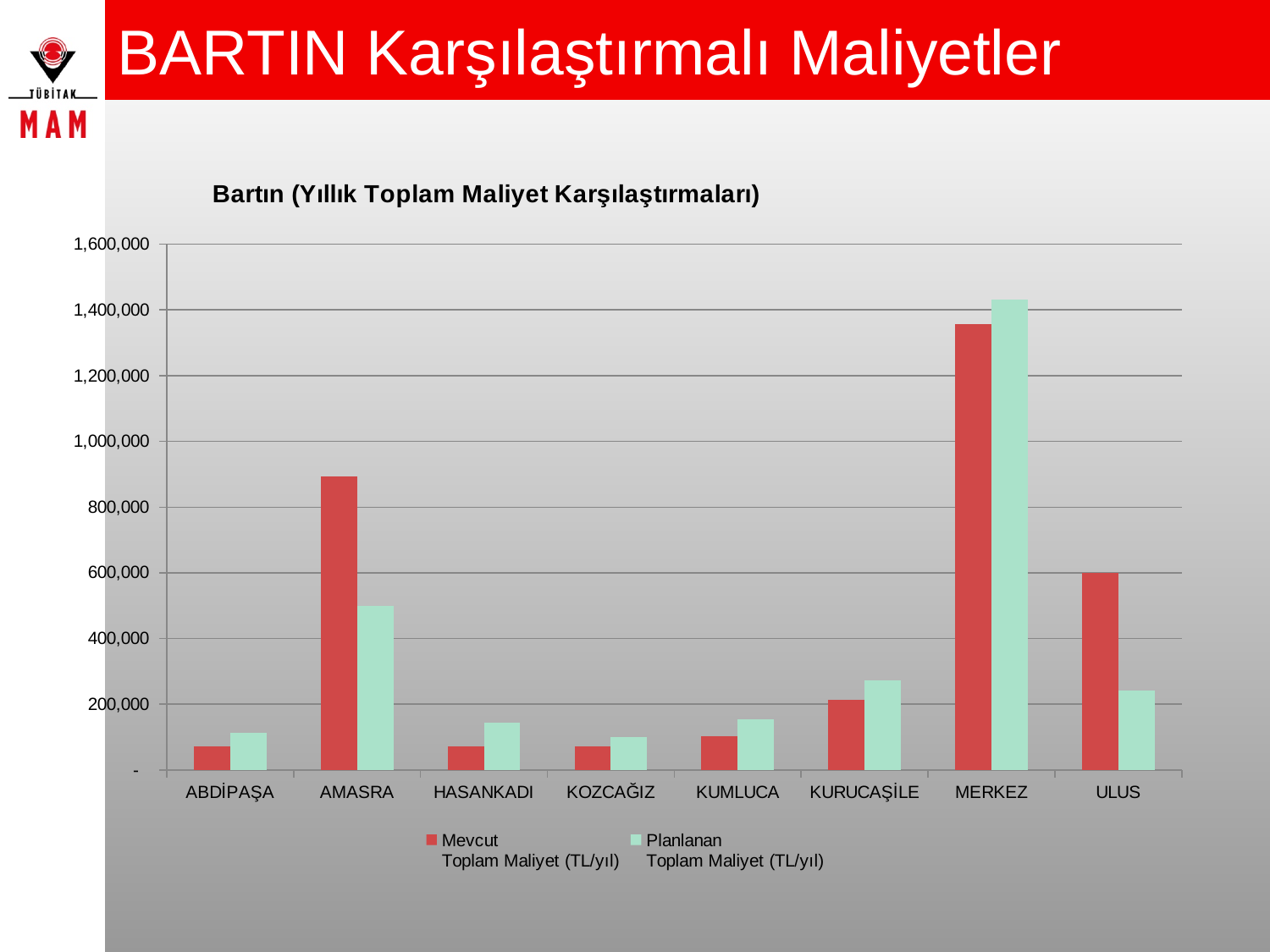
Is the Mevcut Toplam Maliyet value for AMASRA greater or less than 800,000? greater For KURUCAŞİLE, which is larger: Mevcut Toplam Maliyet or Planlanan Toplam Maliyet? Planlanan Toplam Maliyet For AMASRA, which is larger: Mevcut Toplam Maliyet or Planlanan Toplam Maliyet? Mevcut Toplam Maliyet How many categories (districts) are shown on the x axis of the chart? 8 What is the title of the chart? Bartın (Yıllık Toplam Maliyet Karşılaştırmaları) Is the Planlanan Toplam Maliyet value for MERKEZ greater or less than 1,400,000? greater How many series does the chart's legend list? 2 Which district has the highest Planlanan Toplam Maliyet (TL/yıl)? MERKEZ What kind of chart is shown on the slide? bar chart Is the Planlanan Toplam Maliyet value for AMASRA greater or less than 600,000? less Which district has the highest Mevcut Toplam Maliyet (TL/yıl)? MERKEZ For ULUS, which is larger: Mevcut Toplam Maliyet or Planlanan Toplam Maliyet? Mevcut Toplam Maliyet